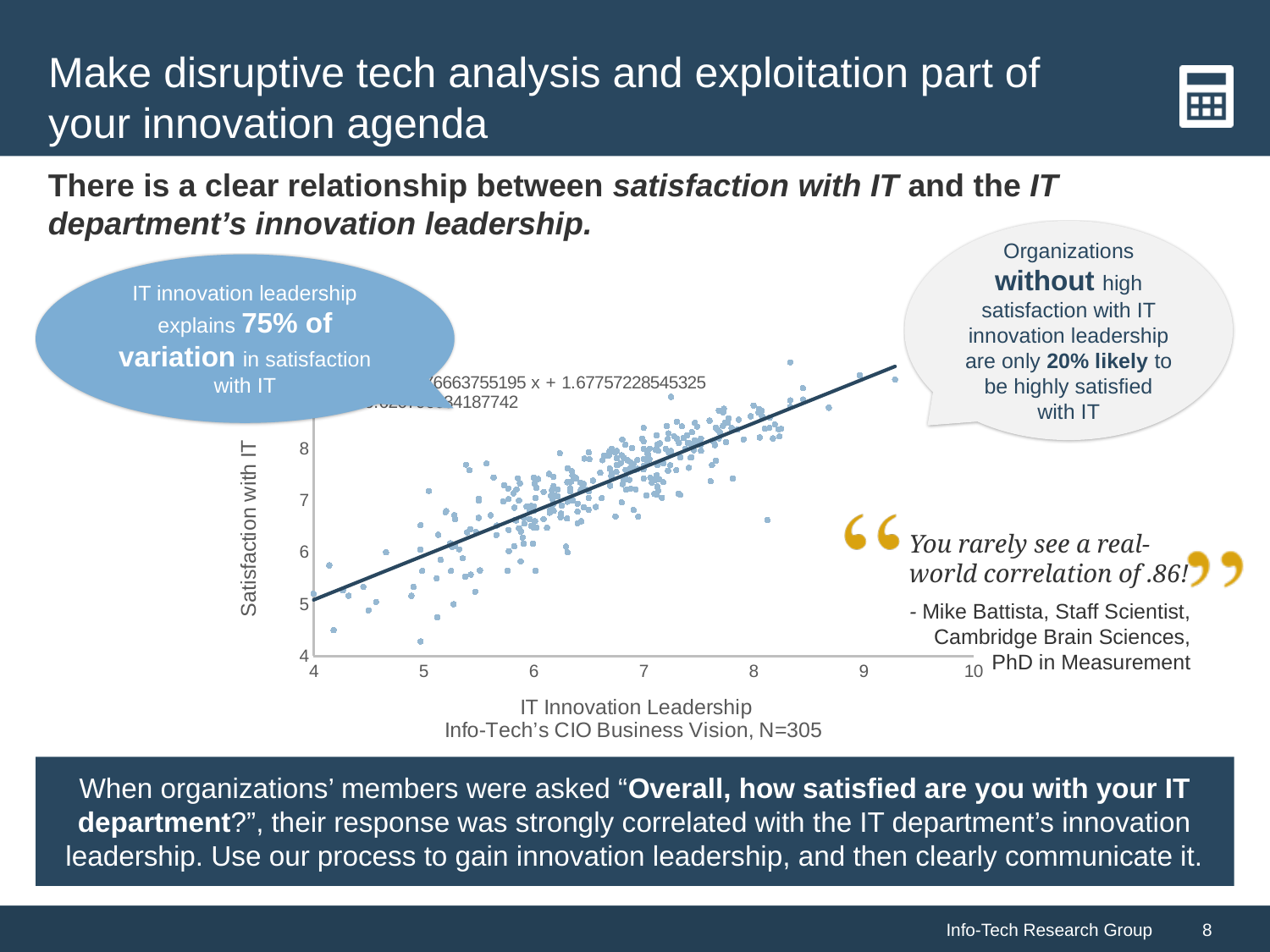
What is the lowest tick value shown on the x axis of the chart? 4 What is the source stated beneath the chart? Info-Tech's CIO Business Vision What is the lowest value shown on the y axis of the chart? 4 What is the label of the x axis of the chart? IT Innovation Leadership What kind of chart is shown on the slide? scatter plot What is the label of the y axis of the chart? Satisfaction with IT Does Satisfaction with IT rise or fall as IT Innovation Leadership increases along the x axis? rise What is the highest tick value shown on the y axis of the chart? 8 What is the highest value shown on the x axis of the chart? 10 What is the sample size (N) stated beneath the chart? 305 Does the trend line on the chart slope upward or downward from left to right? upward